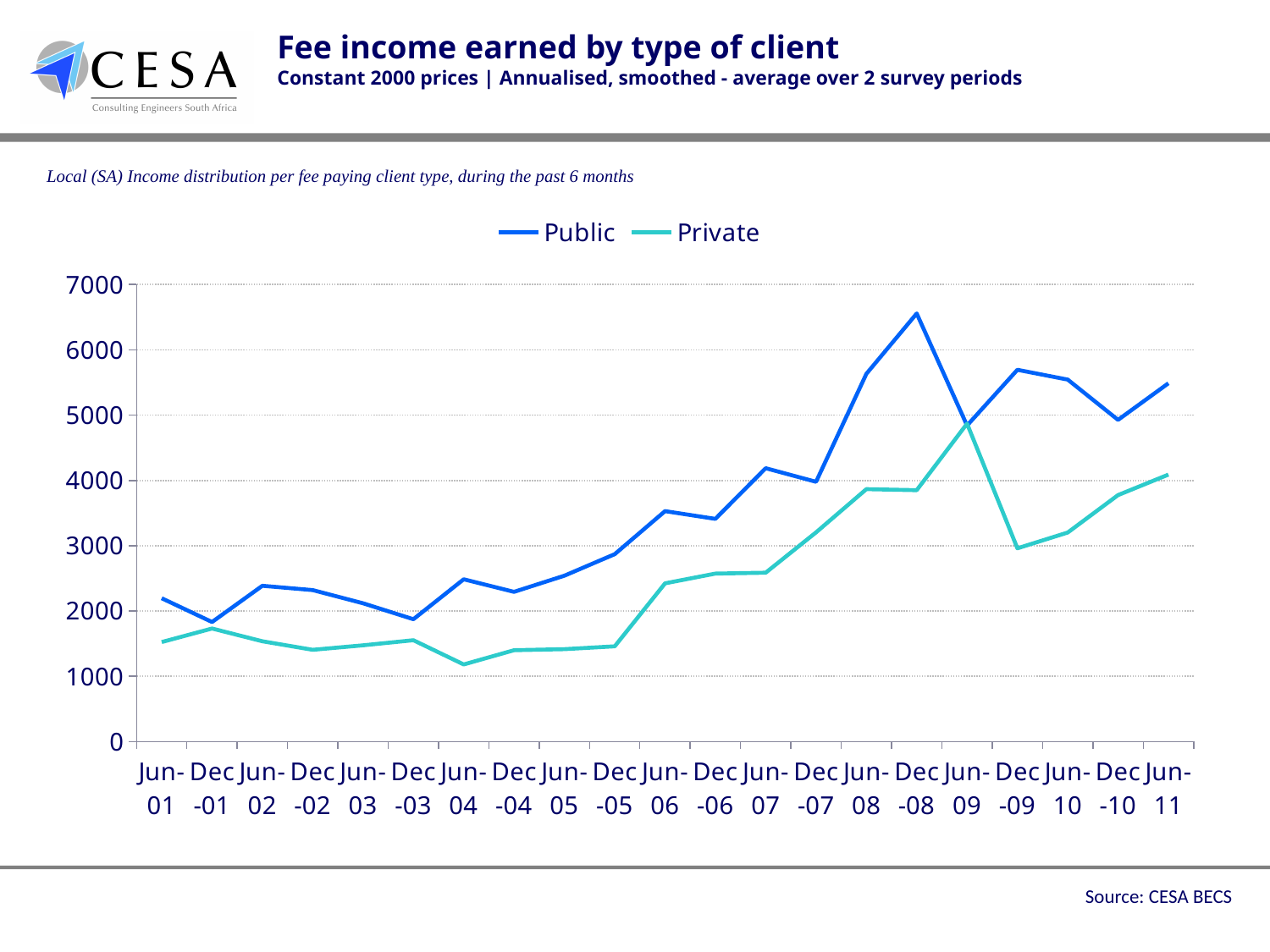
How many survey periods are plotted along the x axis? 21 How many series does the legend list? 2 Which colour is used for the Private series line? Turquoise Is the value for Private in Jun-04 greater or less than 2000? less Is the value for Public in Jun-11 greater or less than 5000? greater Which series has the larger value in Dec-09, Public or Private? Public In which period does the Public series reach its highest value? Dec-08 Is the value for Public in Dec-08 greater or less than 6000? greater In which period does the Private series reach its lowest value? Jun-04 Does the Private series rise or fall between Jun-05 and Jun-09? Rise In which period does the Private series reach its highest value? Jun-09 What kind of chart is shown on the slide? Line chart